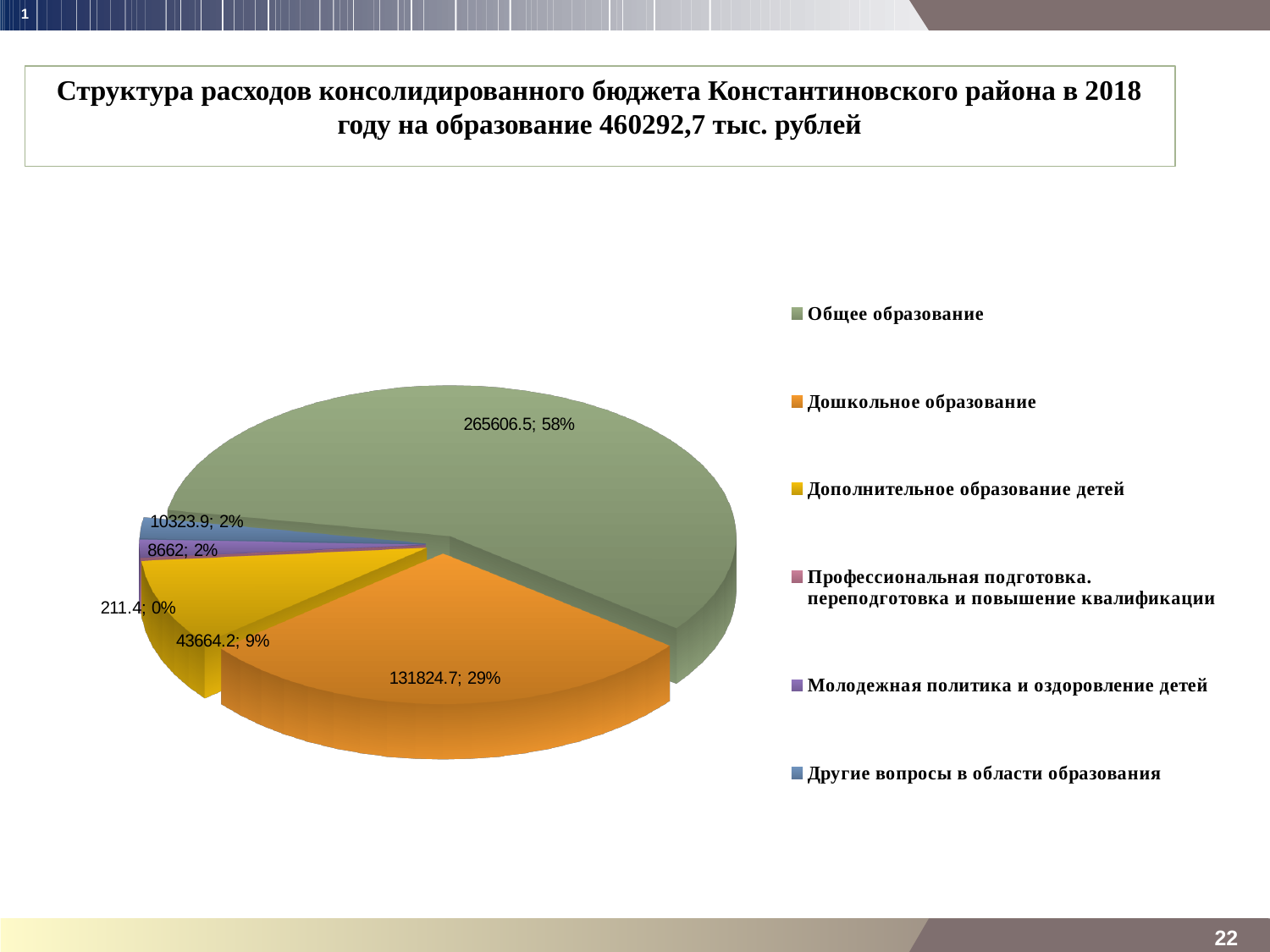
What is the difference between the values for Общее образование and Дошкольное образование? 133781.8 How many categories does the legend of the pie chart list? 6 What value is shown for Дополнительное образование детей? 43664.2 What colour is the slice for Дошкольное образование? Orange Which category has the smallest slice of the pie? Профессиональная подготовка. переподготовка и повышение квалификации What value is shown for Общее образование? 265606.5 Which category has the largest slice of the pie? Общее образование What value is shown for Дошкольное образование? 131824.7 What share of the pie does Дошкольное образование take? 29% What kind of chart is shown on the slide? Pie chart What share of the pie does Общее образование take? 58% Which is larger: the value for Дошкольное образование or the value for Дополнительное образование детей? Дошкольное образование